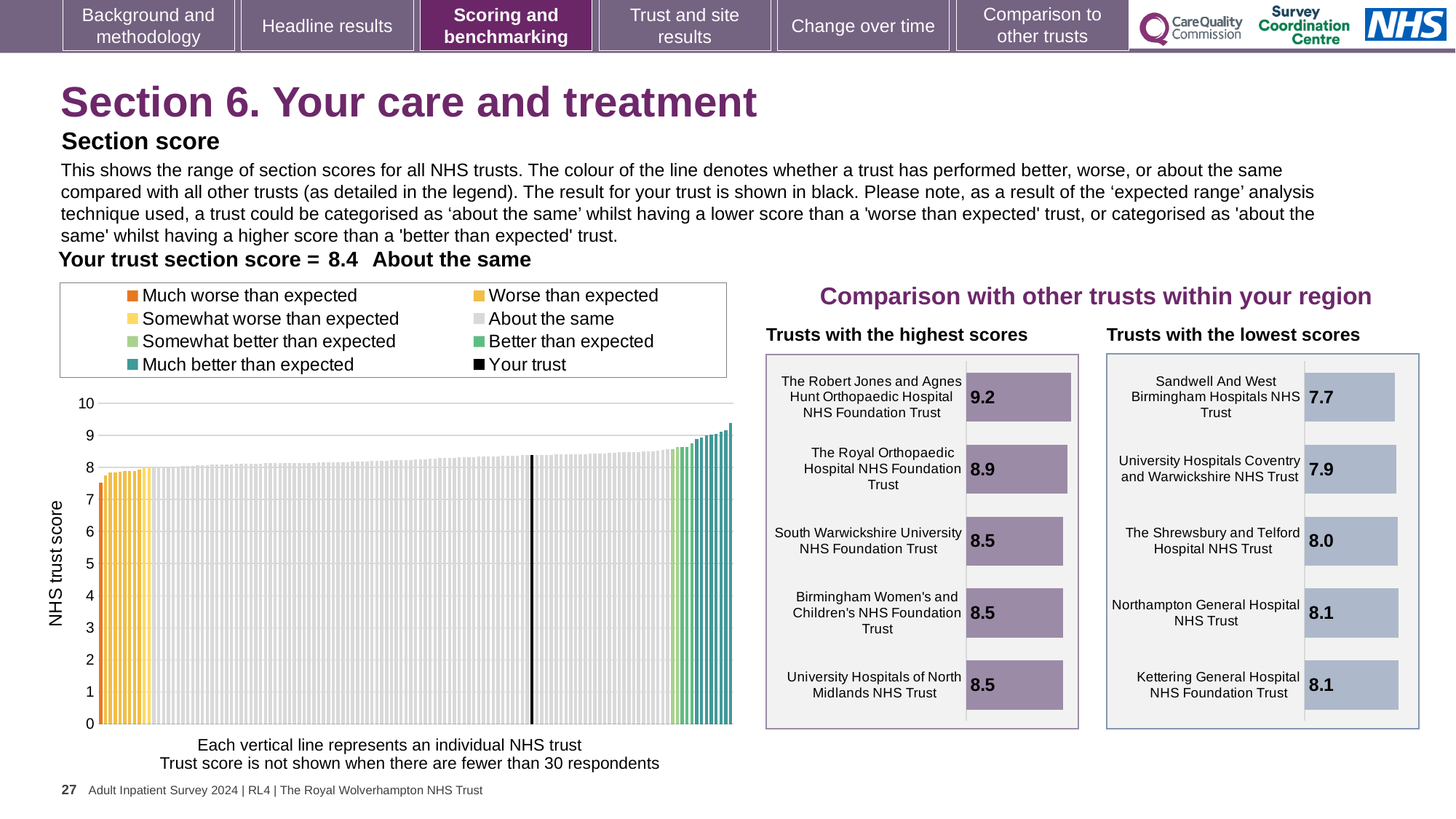
What is the label on the vertical axis of the left-hand chart? NHS trust score In the 'Trusts with the lowest scores' chart, what is the score for Sandwell And West Birmingham Hospitals NHS Trust? 7.7 What kind of chart is the large chart on the left showing NHS trust scores? bar chart In the 'Trusts with the highest scores' chart, which trust has the highest score? The Robert Jones and Agnes Hunt Orthopaedic Hospital NHS Foundation Trust What is the section score for your trust shown on the slide? 8.4 In the left-hand chart, is the value for your trust (the black bar) greater or less than 8? greater In the 'Trusts with the lowest scores' chart, which trust has the lowest score? Sandwell And West Birmingham Hospitals NHS Trust In the left-hand chart, do the trust scores rise or fall from left to right? rise How many trusts are shown in the 'Trusts with the lowest scores' chart? 5 How many entries does the legend of the left-hand chart list? 8 In the 'Trusts with the highest scores' chart, what is the difference between the scores of The Robert Jones and Agnes Hunt Orthopaedic Hospital NHS Foundation Trust and The Royal Orthopaedic Hospital NHS Foundation Trust? 0.3 In the 'Trusts with the highest scores' chart, what is the score for The Robert Jones and Agnes Hunt Orthopaedic Hospital NHS Foundation Trust? 9.2